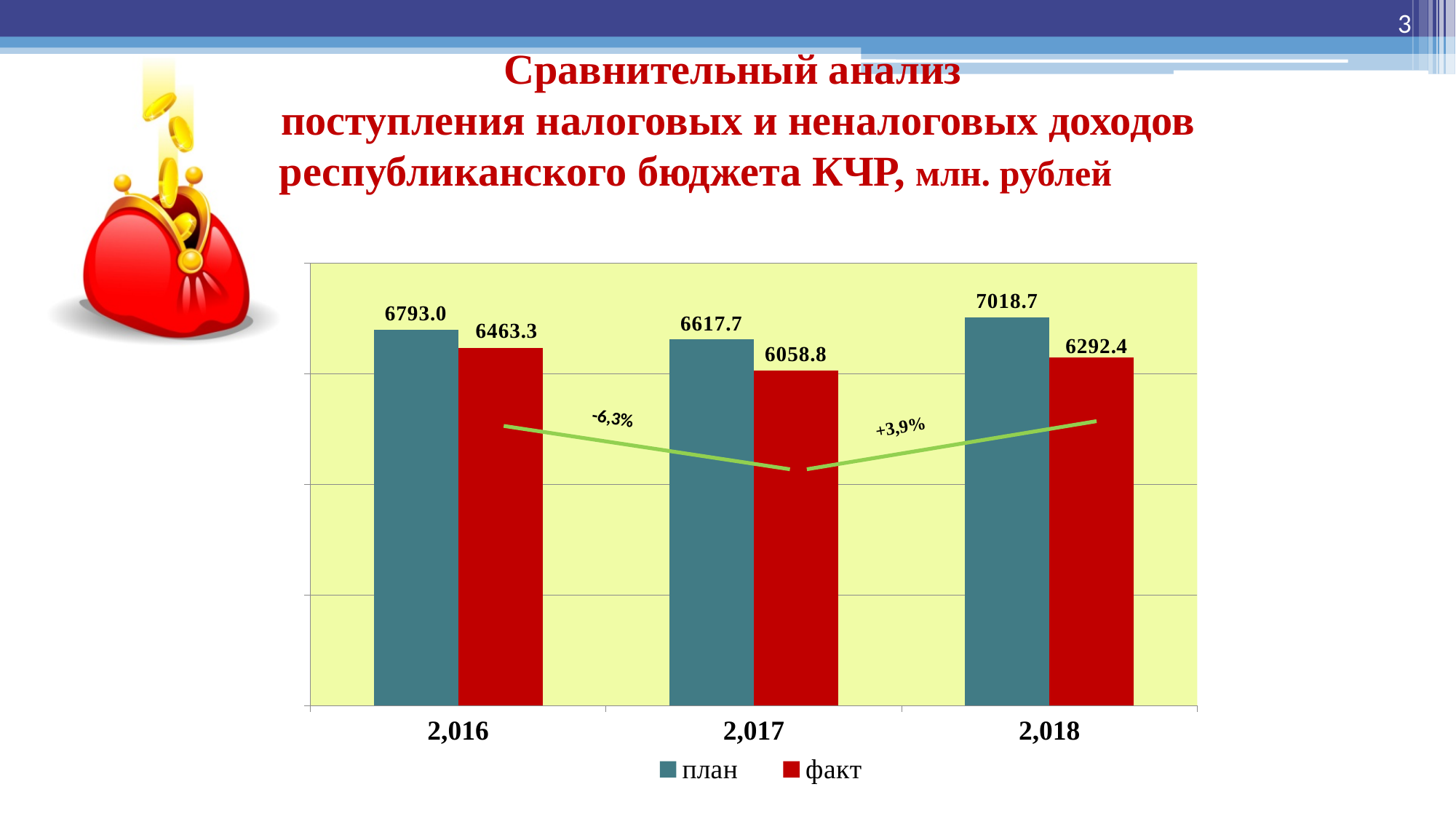
What is the difference between план and факт for 2,018? 726.3 What is the value of факт for 2,018? 6292.4 How many series does the legend list? 2 What is the value of план for 2,018? 7018.7 How many years are shown on the x axis? 3 Which is larger for 2,017: план or факт? план What is the value of план for 2,016? 6793.0 What kind of chart is shown on the slide? bar chart In which year is the факт value lowest? 2,017 In which year is the план value highest? 2,018 What is the difference between план and факт for 2,016? 329.7 What is the value of факт for 2,017? 6058.8